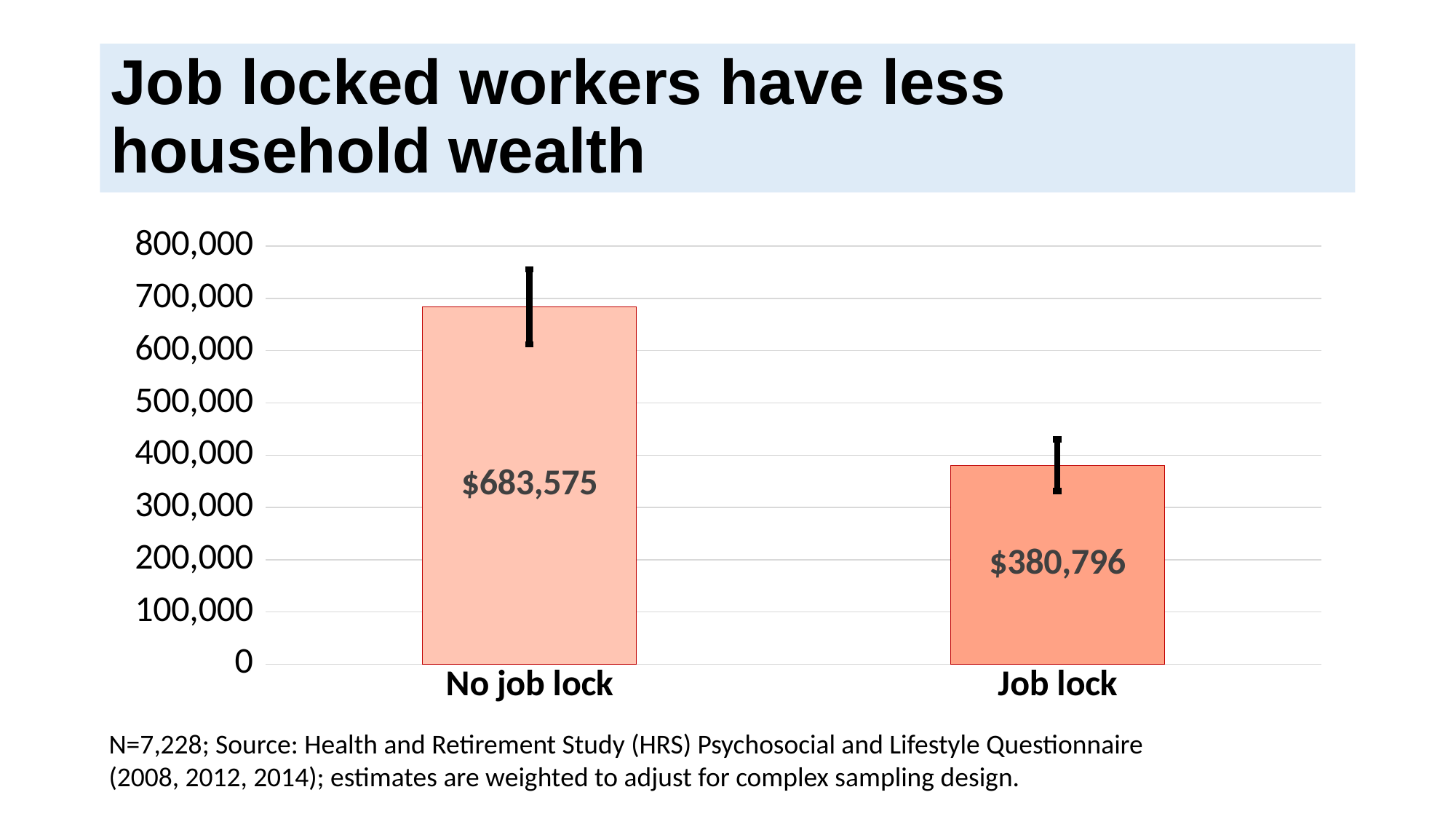
Which category has the higher household wealth? No job lock Is the value for No job lock greater or less than 600,000? greater What is the highest value shown on the y axis? 800,000 What is the sample size (N) stated in the note below the chart? 7,228 Is the value for Job lock greater or less than 400,000? less What is the household wealth value for No job lock? $683,575 What is the title of the slide? Job locked workers have less household wealth What kind of chart is shown on the slide? bar chart What is the household wealth value for Job lock? $380,796 What is the difference in household wealth between No job lock and Job lock? $302,779 How many categories are shown on the x axis? 2 Which category has the lower household wealth? Job lock